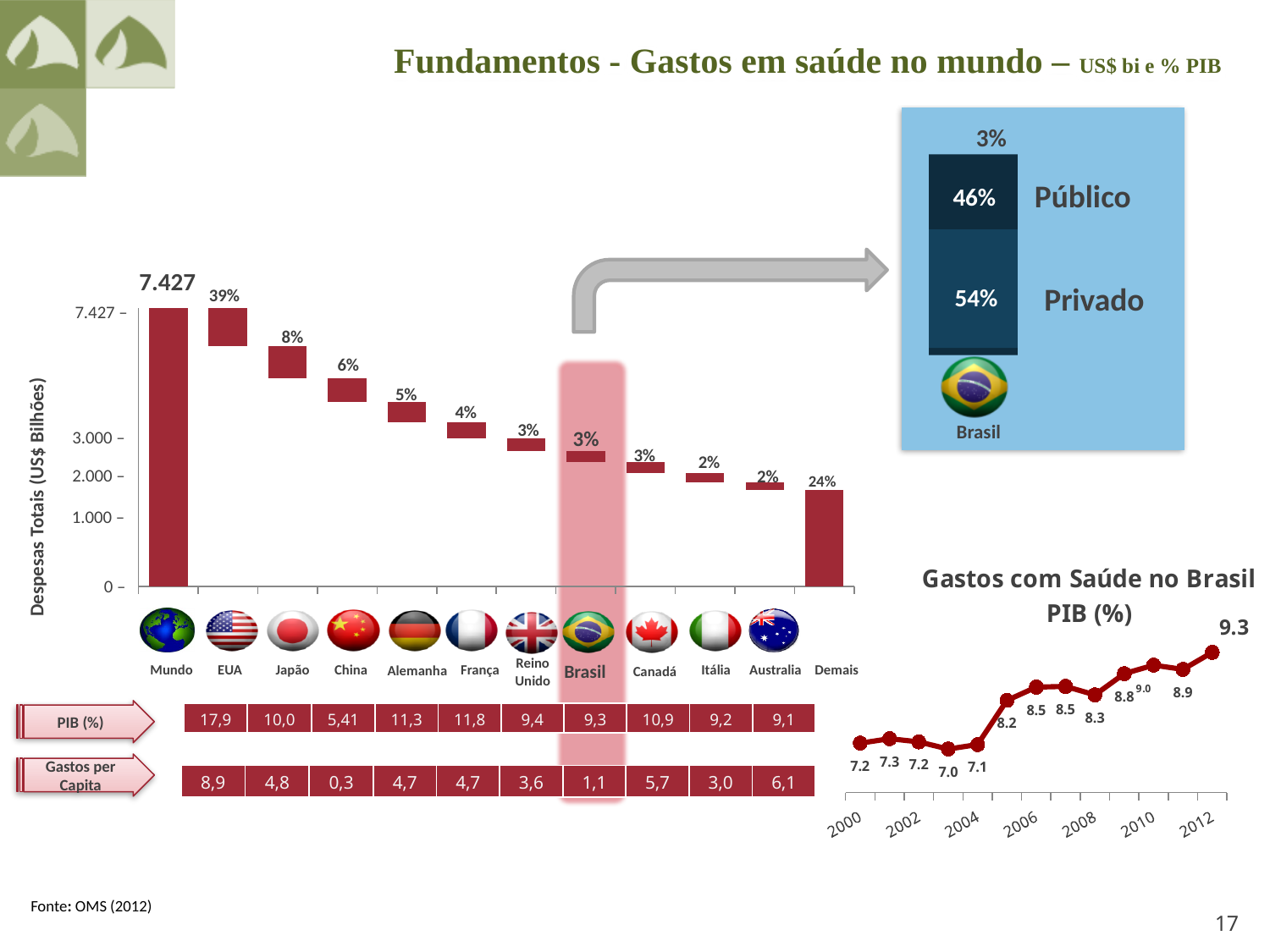
In the line chart 'Gastos com Saúde no Brasil PIB (%)', what is the lowest value plotted? 7.0 In the line chart 'Gastos com Saúde no Brasil PIB (%)', what is the value for 2012? 9.3 In the bar chart on the left, which country has the highest percentage share? EUA In the stacked bar for Brasil at the top right, what share is labelled Privado? 54% In the bar chart on the left, what percentage is shown for EUA? 39% In the bar chart on the left, which has the larger percentage, Japão or China? Japão In the line chart 'Gastos com Saúde no Brasil PIB (%)', what is the difference between the 2012 value and the 2000 value? 2.1 In the line chart 'Gastos com Saúde no Brasil PIB (%)', do the values generally rise or fall from 2000 to 2012? rise In the bar chart on the left, what value is shown for Mundo? 7.427 In the line chart 'Gastos com Saúde no Brasil PIB (%)', what is the value for 2000? 7.2 What kind of chart is the large chart on the left showing 'Despesas Totais (US$ Bilhões)' by country? bar chart In the bar chart on the left, what percentage is shown for Brasil? 3%